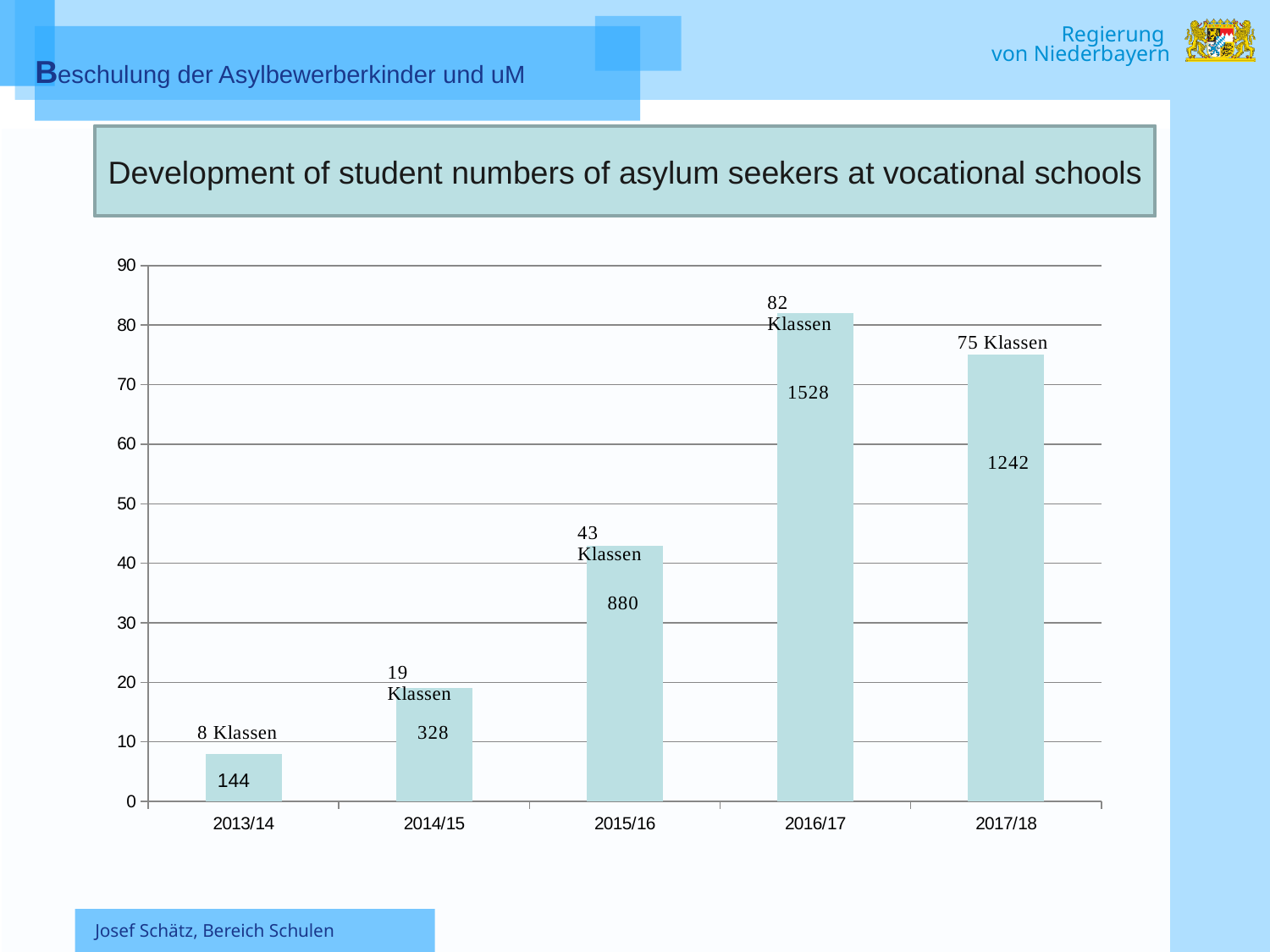
What kind of chart is shown on the slide? bar chart Is the bar for 2017/18 greater or less than 70 on the axis? greater What is the number of students shown for 2016/17? 1528 What is the difference in the number of classes between 2015/16 and 2014/15? 24 Which school year has the highest bar? 2016/17 How many classes (Klassen) are shown for 2015/16? 43 Klassen Which school year has the lowest bar? 2013/14 What is the student number labelled on the bar for 2013/14? 144 What is the title of the chart? Development of student numbers of asylum seekers at vocational schools How many school years are shown on the x axis? 5 What is the difference in student numbers between 2016/17 and 2017/18? 286 Which has more students, 2015/16 or 2017/18? 2017/18